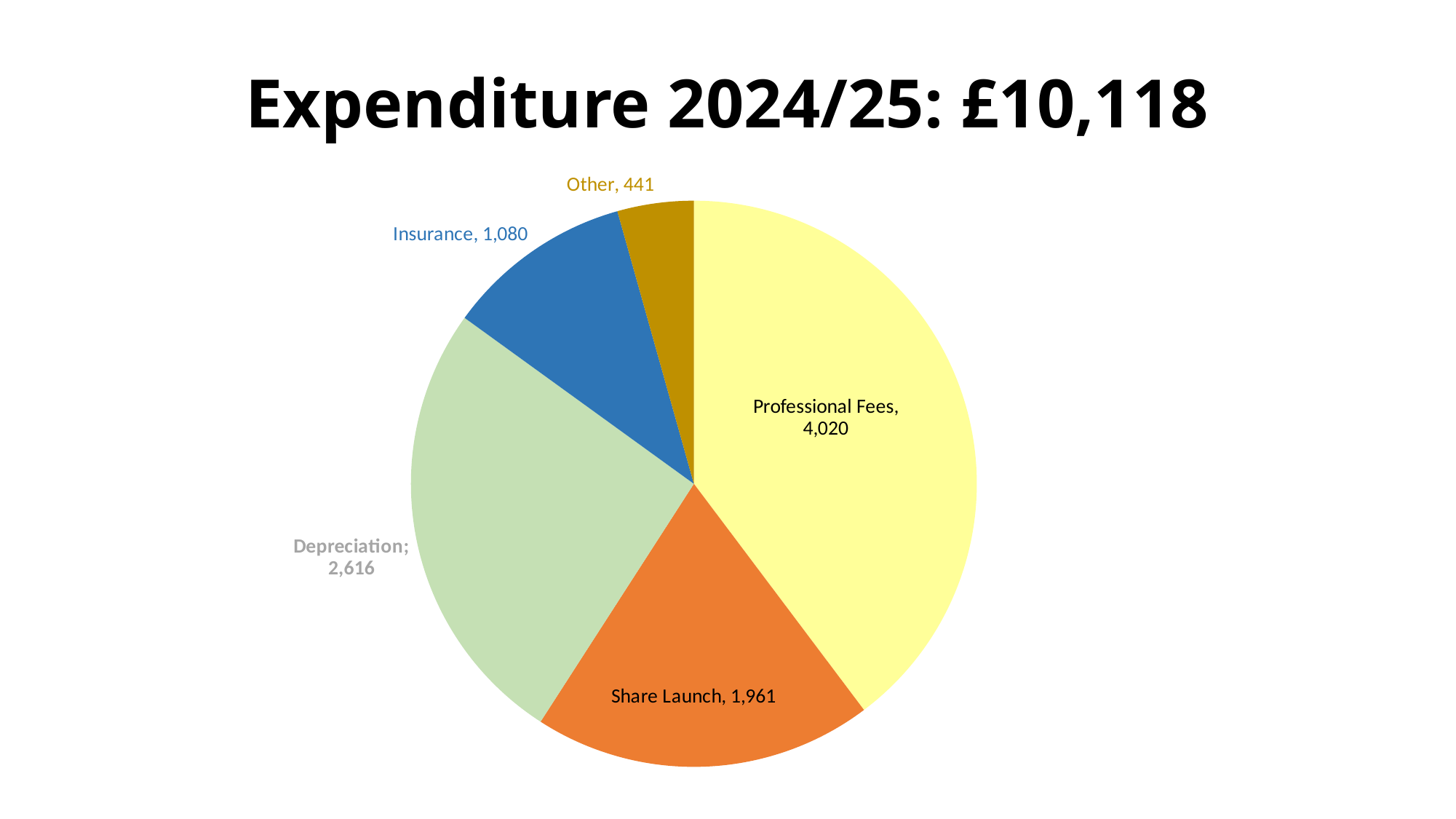
What kind of chart is shown on the slide? Pie chart Which is larger, Share Launch or Insurance? Share Launch Which category has the smallest slice of the pie? Other What is the value of the Other slice? 441 What is the difference between Professional Fees and Depreciation? 1,404 What is the value of the Depreciation slice? 2,616 What is the value of the Insurance slice? 1,080 What is the difference between Depreciation and Share Launch? 655 Which category has the largest slice of the pie? Professional Fees What is the title of the chart? Expenditure 2024/25: £10,118 How many slices does the pie chart have? 5 What is the value of the Professional Fees slice? 4,020